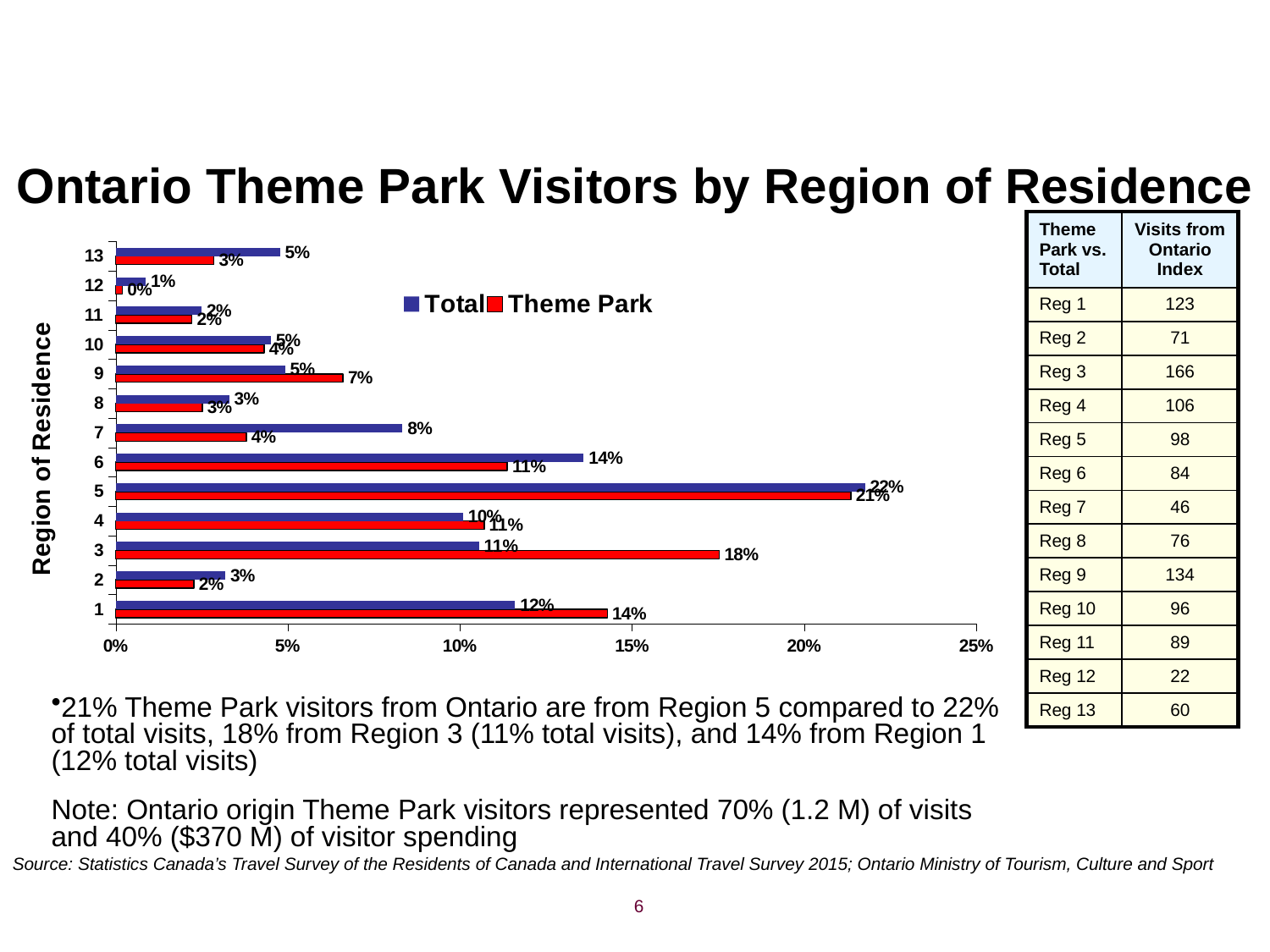
What is the Theme Park value for Region 3? 18% What is the difference between the Theme Park and Total values for Region 3? 7 percentage points Which region has the highest Theme Park value? Region 5 What kind of chart is shown on the slide? Bar chart What is the Total value for Region 7? 8% How many series does the legend list? 2 Is the Total value for Region 6 greater or less than 10%? greater What is the Total value for Region 13? 5% For Region 9, which is larger: the Total value or the Theme Park value? Theme Park How many regions of residence are shown on the chart? 13 Which region has the lowest Theme Park value? Region 12 What is the Theme Park value for Region 5? 21%